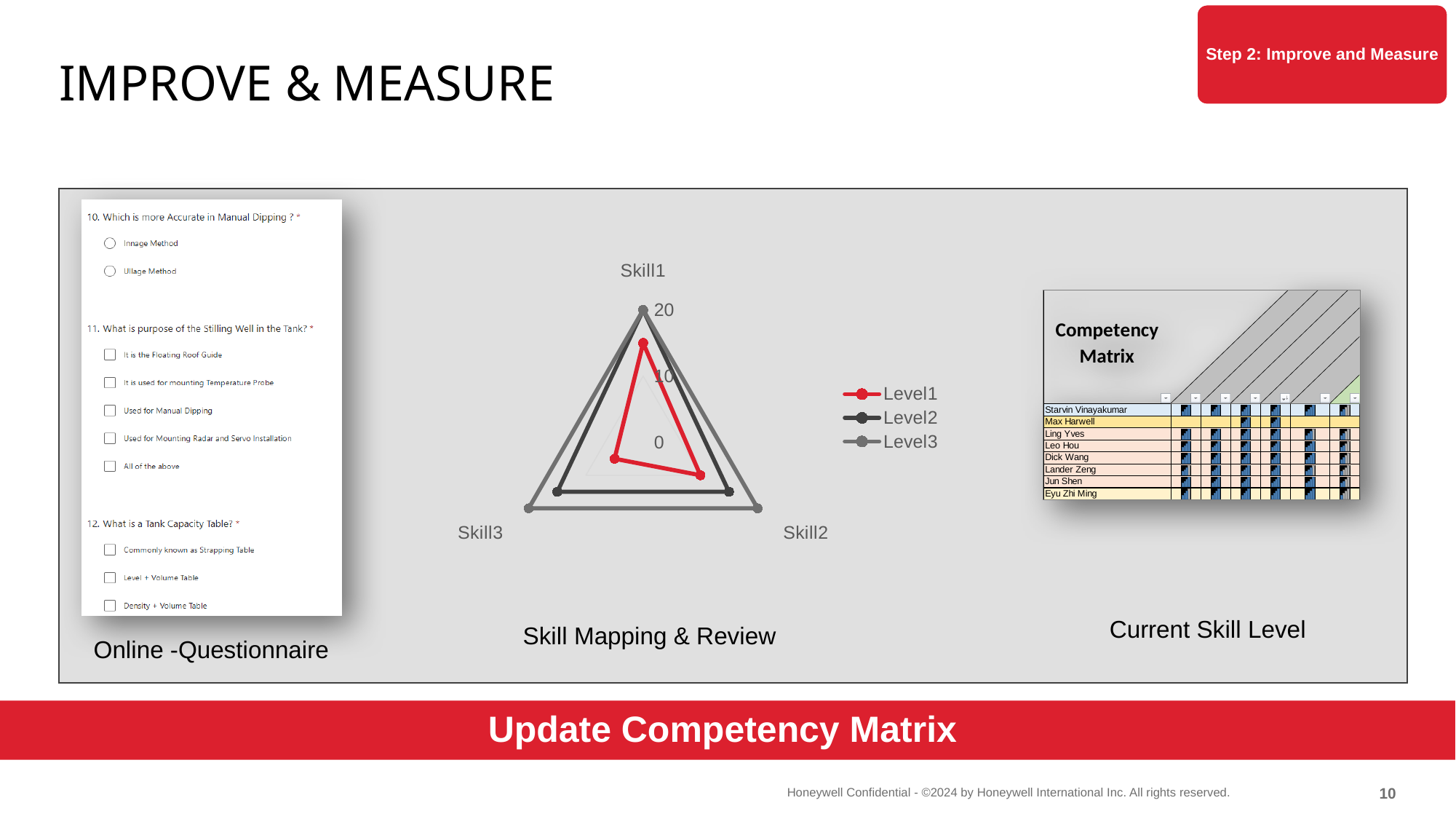
What is the highest tick value shown on the radar chart's axis? 20 Is the Level1 value for Skill1 greater or less than 10? greater Which series has the lowest values on the radar chart? Level1 What kind of chart is shown under "Skill Mapping & Review"? radar chart What colour is the Level1 series on the radar chart? red Is the Level2 value for Skill1 greater or less than 10? greater What is the value of Level3 on the Skill1 axis of the radar chart? 20 Is the Level1 value for Skill3 greater or less than 10? less For Level1, which is larger: the value for Skill1 or the value for Skill3? Skill1 How many skill axes does the radar chart have? 3 How many series does the legend of the radar chart list? 3 Which series has the highest values on the radar chart? Level3